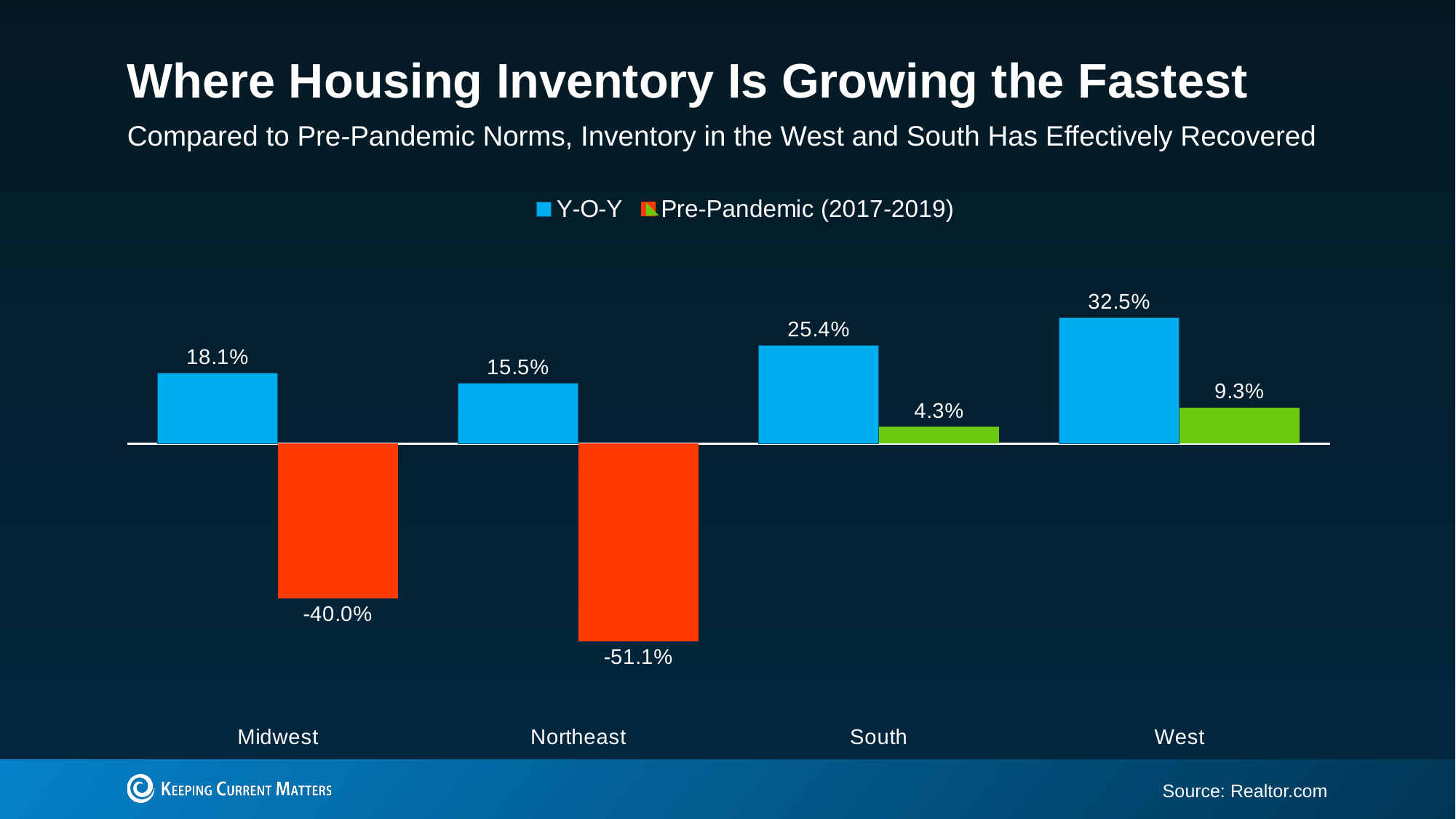
What is the Y-O-Y value for the Midwest? 18.1% What is the source cited for the chart? Realtor.com Which region has the lowest Pre-Pandemic (2017-2019) value? Northeast What is the difference between the Y-O-Y value for the West and the Y-O-Y value for the Northeast? 17.0% What is the Y-O-Y value for the West? 32.5% What kind of chart is shown on the slide? Bar chart How many series does the legend list? 2 How many regions are shown on the chart? 4 What is the Pre-Pandemic (2017-2019) value for the Northeast? -51.1% What is the Pre-Pandemic (2017-2019) value for the South? 4.3% Which is larger: the Pre-Pandemic (2017-2019) value for the West or for the South? West Which region has the highest Y-O-Y value? West